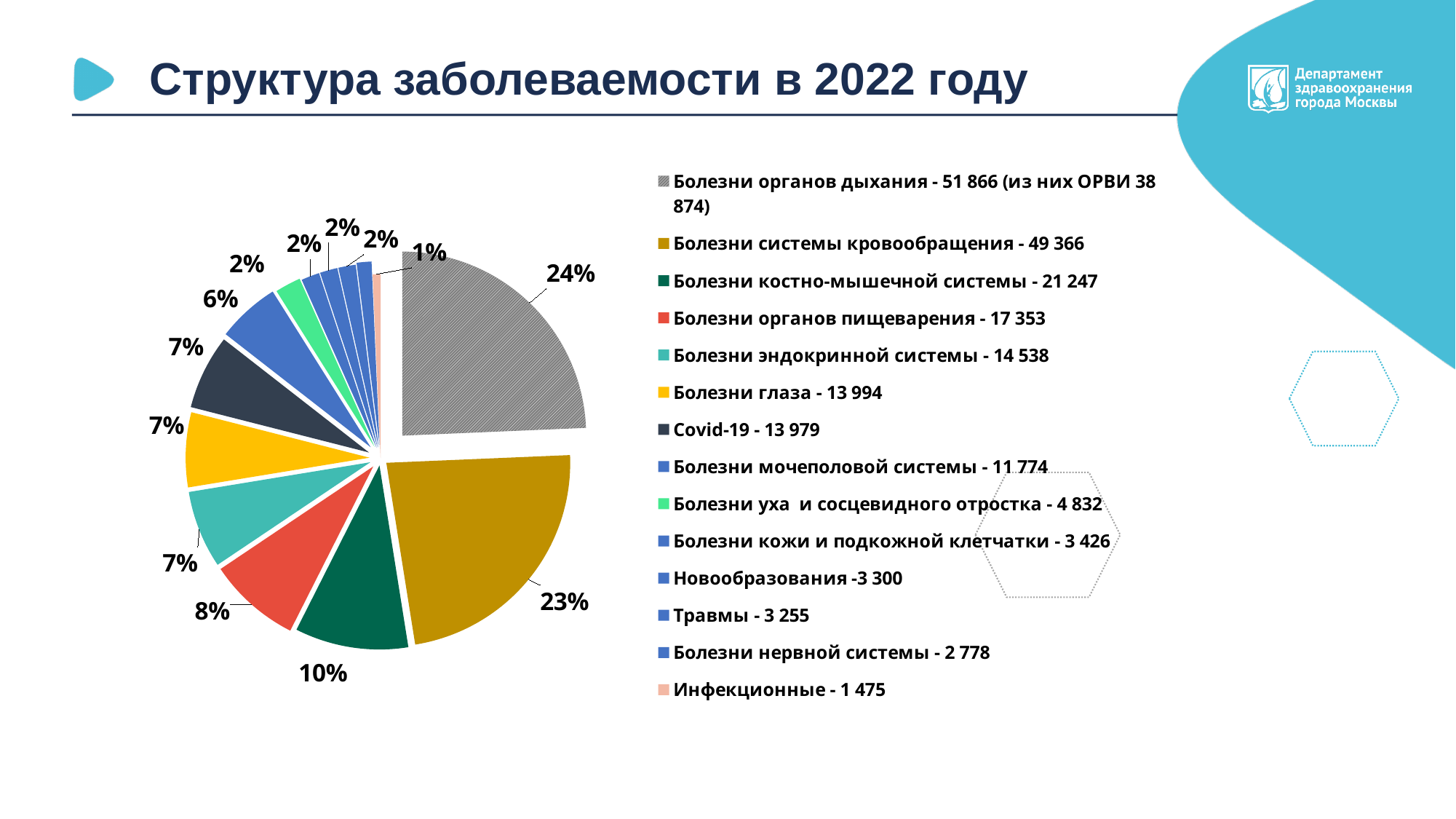
According to the legend, how many cases are listed for Covid-19? 13 979 What share of the pie does "Болезни органов дыхания" take? 24% Which has more cases: "Болезни органов пищеварения" or "Болезни эндокринной системы"? Болезни органов пищеварения What share of the pie does "Болезни системы кровообращения" take? 23% Which category has the largest slice of the pie? Болезни органов дыхания How many categories does the legend list? 14 What is the difference between the number of cases for "Болезни органов дыхания" (51 866) and "Болезни системы кровообращения" (49 366)? 2 500 What share of the pie does "Болезни органов пищеварения" take? 8% Which category has the smallest slice of the pie? Инфекционные What type of chart is shown on the slide? pie chart According to the legend, how many cases are listed for "Болезни эндокринной системы"? 14 538